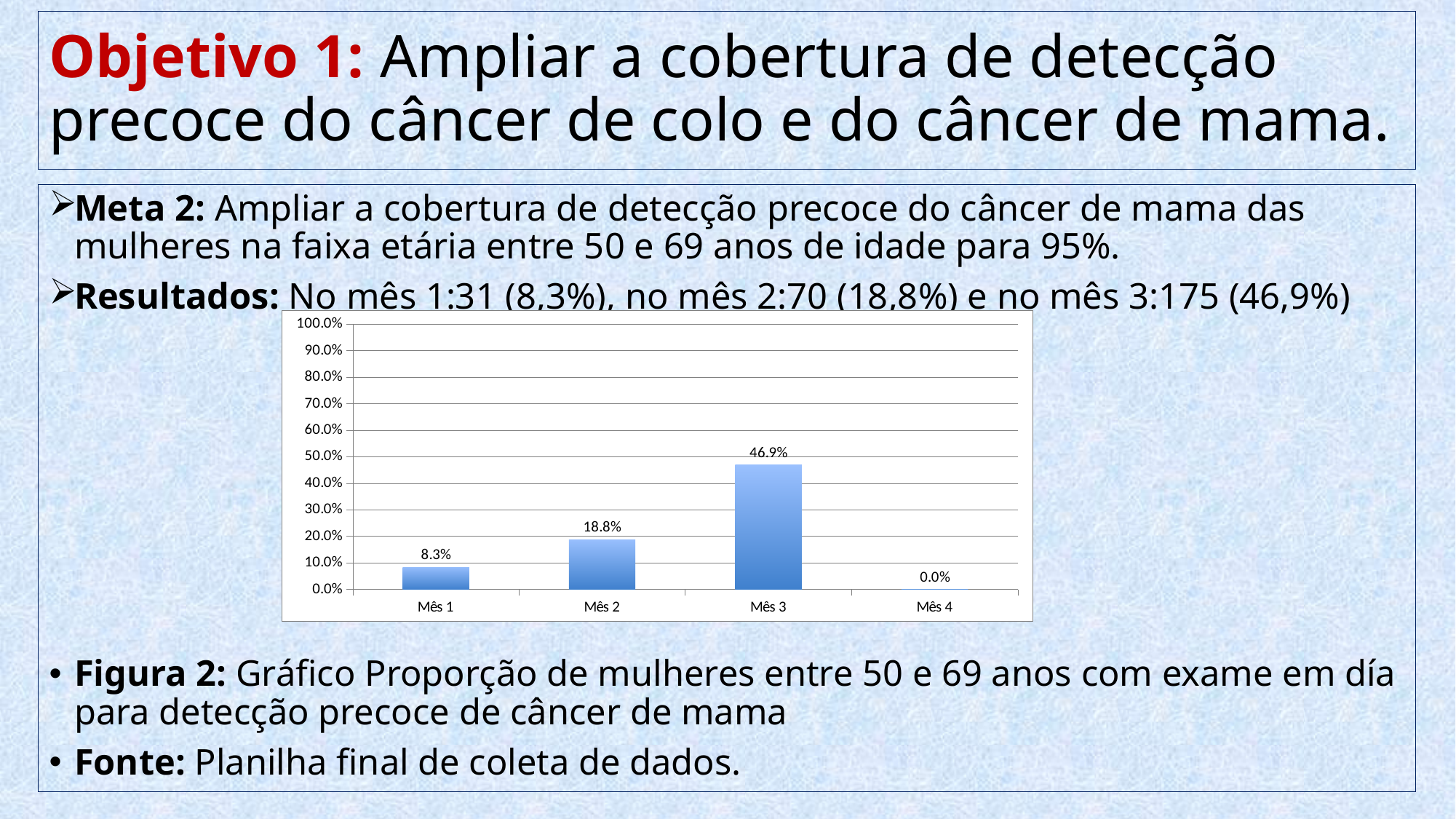
How many months are shown on the x axis? 4 What is the value for Mês 4? 0.0% What is the value for Mês 2? 18.8% Which month has the highest value? Mês 3 What is the value for Mês 3? 46.9% What is the difference between the values for Mês 3 and Mês 2? 28.1% What kind of chart is shown? bar chart What is the value for Mês 1? 8.3% Is the value for Mês 3 greater or less than 50.0%? less Do the values rise or fall from Mês 1 to Mês 3? rise Which month has the lowest value? Mês 4 Which is larger, the value for Mês 1 or the value for Mês 2? Mês 2